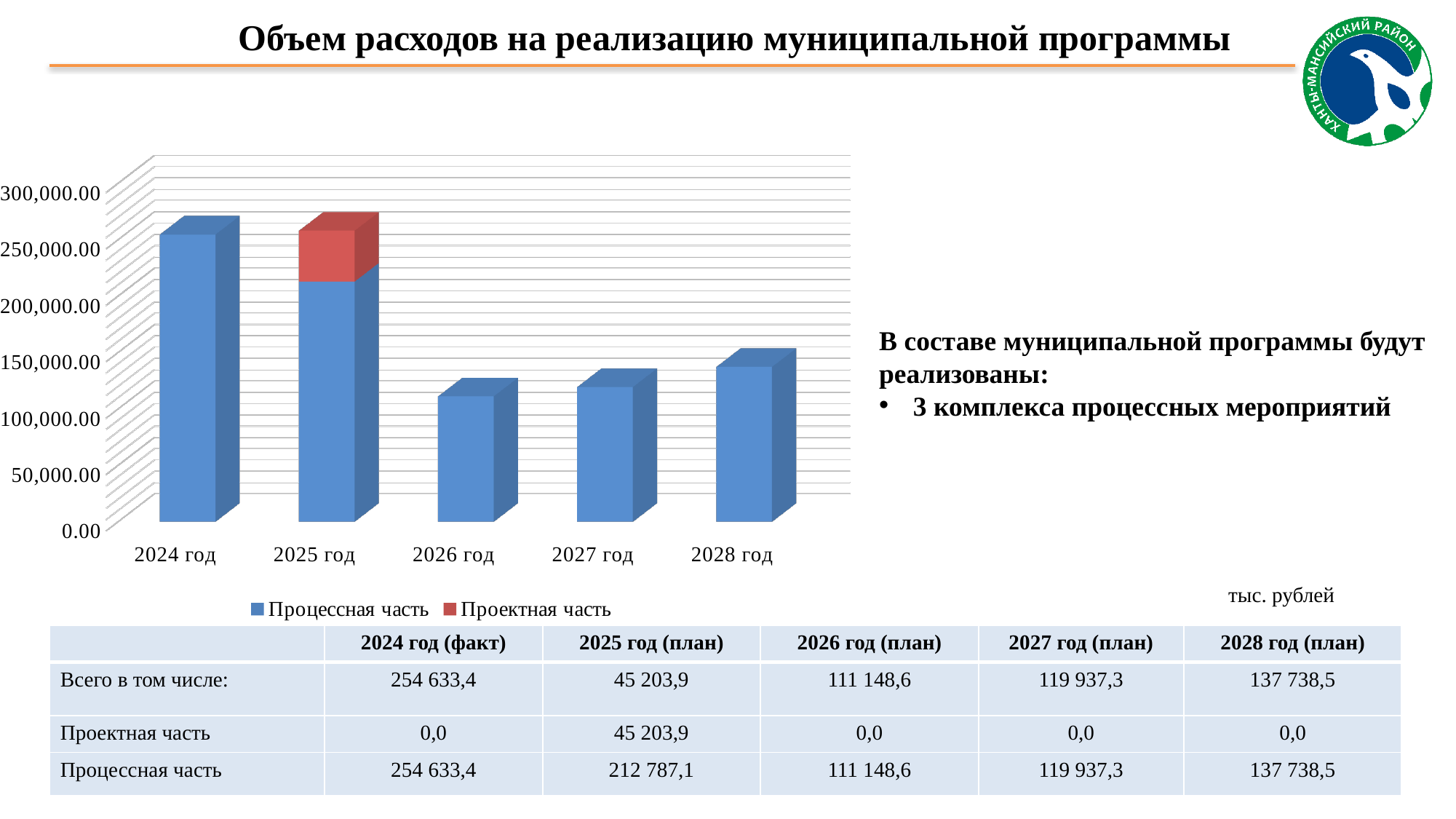
What are the two series named in the chart legend? Процессная часть, Проектная часть Which year is the only one with a red (Проектная часть) segment in the chart? 2025 год Which bar is taller in the chart, 2028 год or 2026 год? 2028 год What kind of chart is shown on the slide? bar chart How many year categories are shown on the x axis of the chart? 5 Do the bar values rise or fall from 2026 год to 2028 год? rise Is the value for 2024 год in the chart greater or less than 200,000.00? greater How many series does the chart legend list? 2 According to the table on the slide, what is the Процессная часть value for 2025 год (план)? 212 787,1 Which year has the lowest bar in the chart? 2026 год According to the table on the slide, what is the Проектная часть value for 2025 год (план)? 45 203,9 Is the value for 2028 год in the chart greater or less than 150,000.00? less